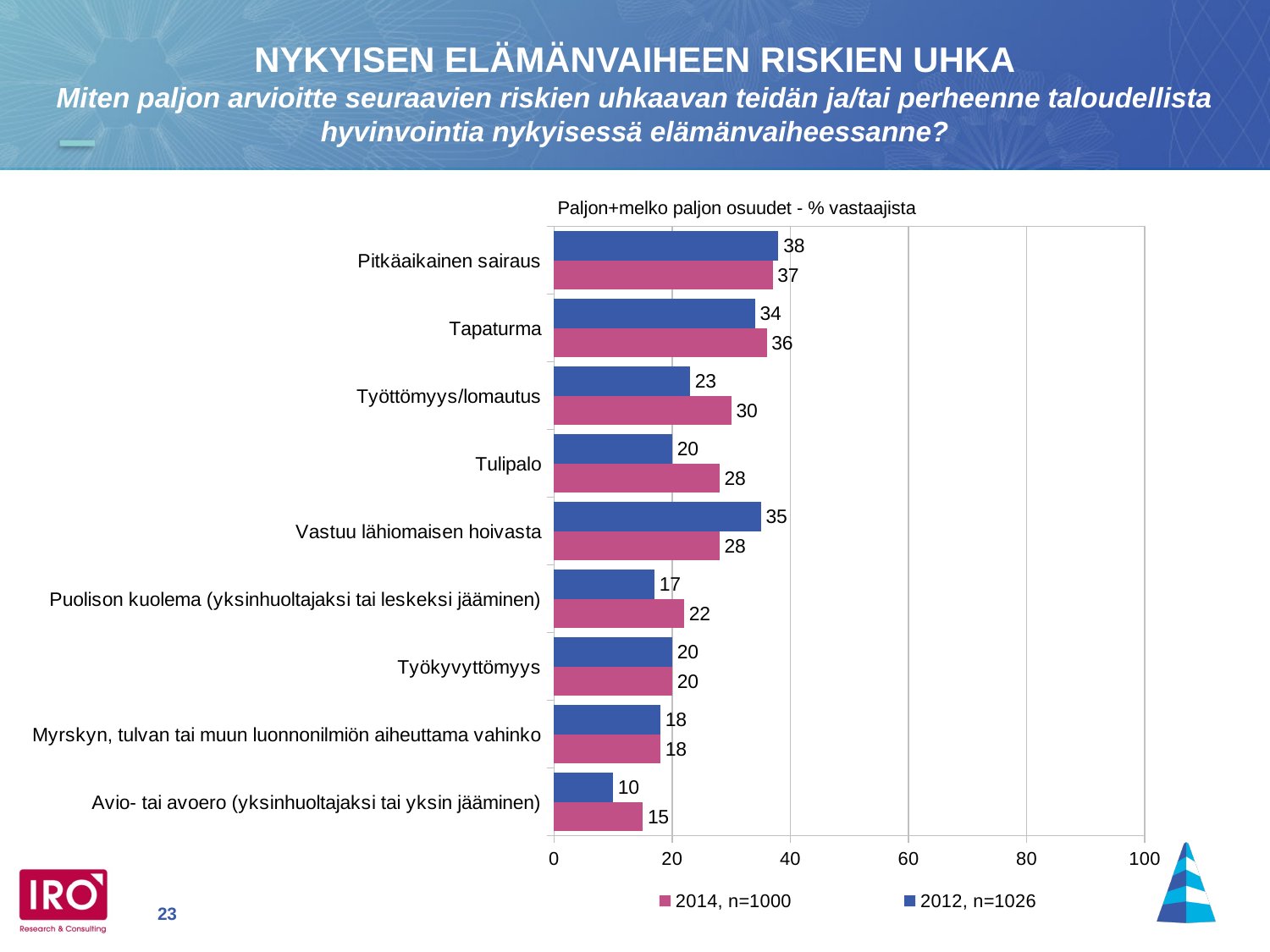
What kind of chart is shown on the slide? bar chart How many series does the legend list? 2 Which category has the lowest 2014 value? Avio- tai avoero (yksinhuoltajaksi tai yksin jääminen) Which category has the highest 2012 value? Pitkäaikainen sairaus What is the subtitle printed above the chart? Paljon+melko paljon osuudet - % vastaajista Is the 2012 value for Pitkäaikainen sairaus greater or less than 20? greater What is the 2012 value for Vastuu lähiomaisen hoivasta? 35 What is the difference between the 2014 and 2012 values for Tulipalo? 8 For Tapaturma, which series has the larger value, 2014 or 2012? 2014 What is the 2014 value for Työttömyys/lomautus? 30 How many categories are shown on the chart? 9 What is the 2014 value for Tulipalo? 28